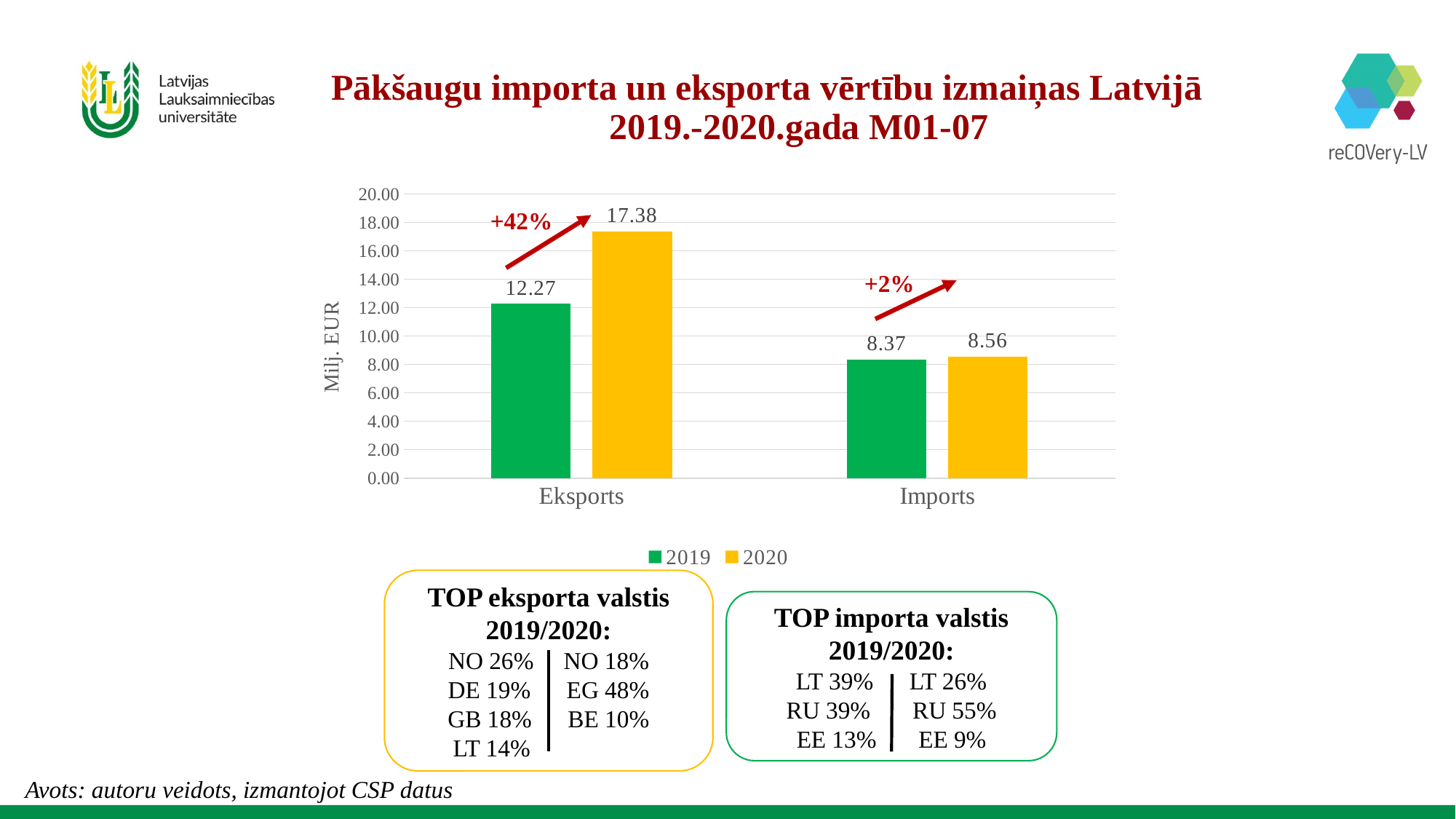
What is the value for Imports in 2020? 8.56 What is the value for Imports in 2019? 8.37 What is the value for Eksports in 2020? 17.38 Which bar has the highest value on the chart? Eksports 2020 What is the difference between the Eksports values for 2020 and 2019? 5.11 How many series does the legend list? 2 What is the value for Eksports in 2019? 12.27 What kind of chart is shown on the slide? Bar chart Which is larger, the Eksports value for 2019 or the Imports value for 2020? Eksports 2019 How many categories are shown on the x axis? 2 What percentage change is annotated above the Eksports bars? +42% Which bar has the lowest value on the chart? Imports 2019